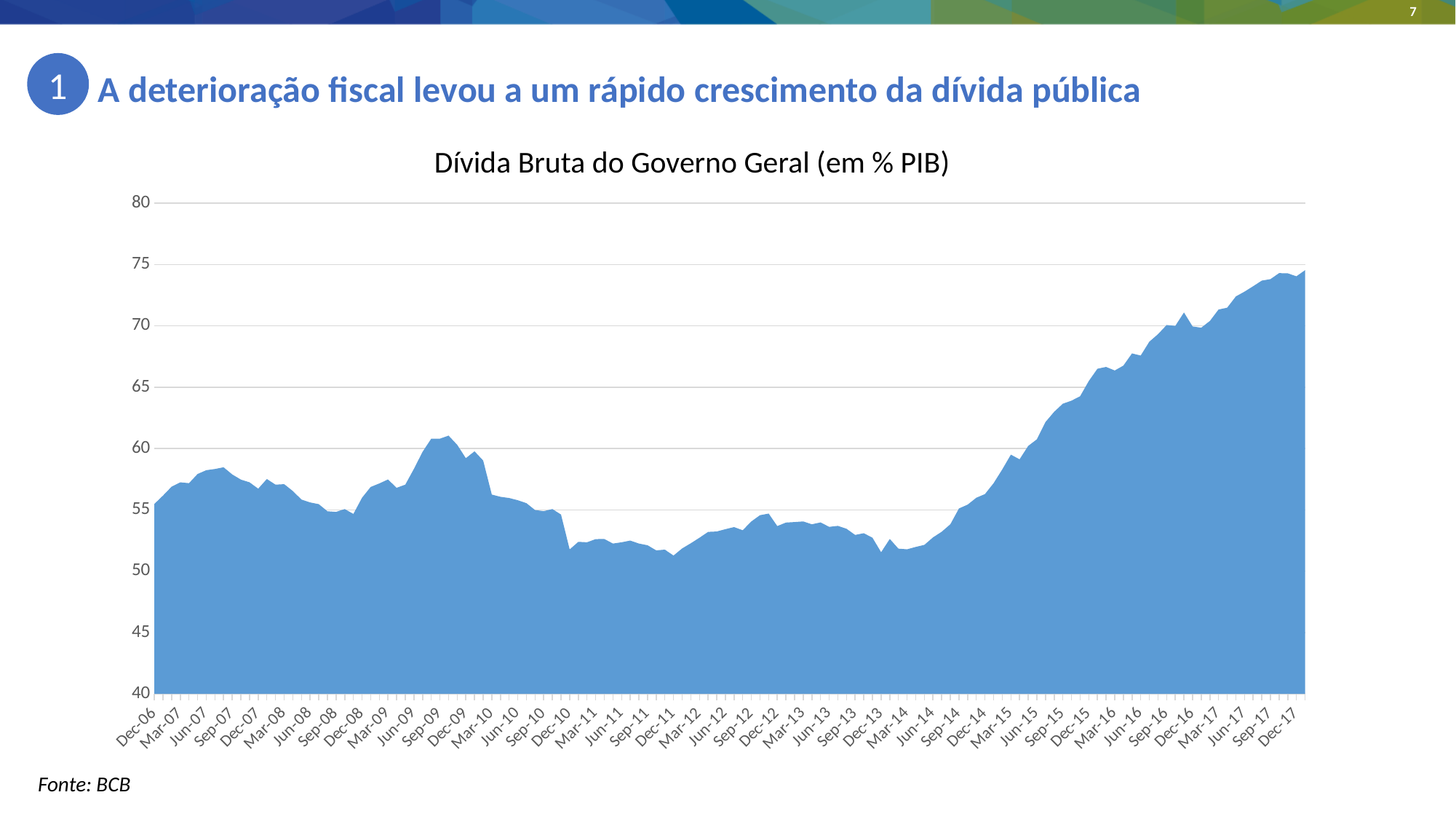
Is the value for Dec-11 greater or less than 55? less What kind of chart is shown on the slide? Area chart Do the values rise or fall between Dec-13 and Dec-17? rise What is the title of the chart? Dívida Bruta do Governo Geral (em % PIB) Which date on the x axis has the highest value? Dec-17 Do the values rise or fall between Dec-09 and Dec-11? fall What source is cited for the chart? BCB Is the value for Dec-17 greater or less than 70? greater Is the value for Dec-06 greater or less than 50? greater Which is larger, the value for Dec-17 or the value for Dec-06? Dec-17